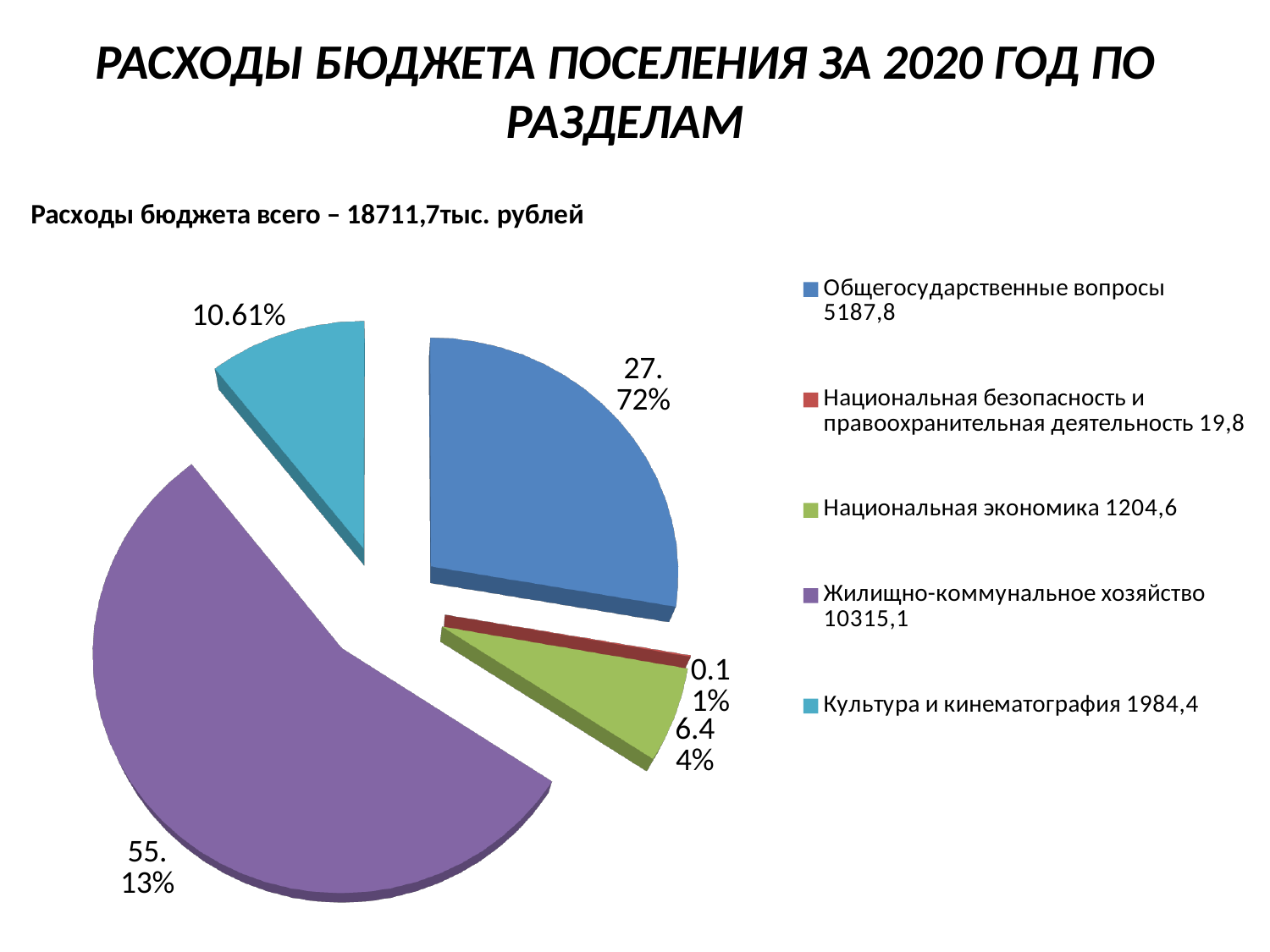
Which has a larger share: Культура и кинематография or Национальная экономика? Культура и кинематография What share of the pie does Жилищно-коммунальное хозяйство take? 55.13% Which section has the smallest share of the pie? Национальная безопасность и правоохранительная деятельность What share of the pie does Общегосударственные вопросы take? 27.72% How many slices does the pie chart have? 5 What share of the pie does Культура и кинематография take? 10.61% Which section has the largest share of the pie? Жилищно-коммунальное хозяйство What is the difference in percentage points between the shares of Жилищно-коммунальное хозяйство and Общегосударственные вопросы? 27.41 What kind of chart is shown on the slide? pie chart What value is shown in the legend for Национальная экономика? 1204,6 How many entries does the legend list? 5